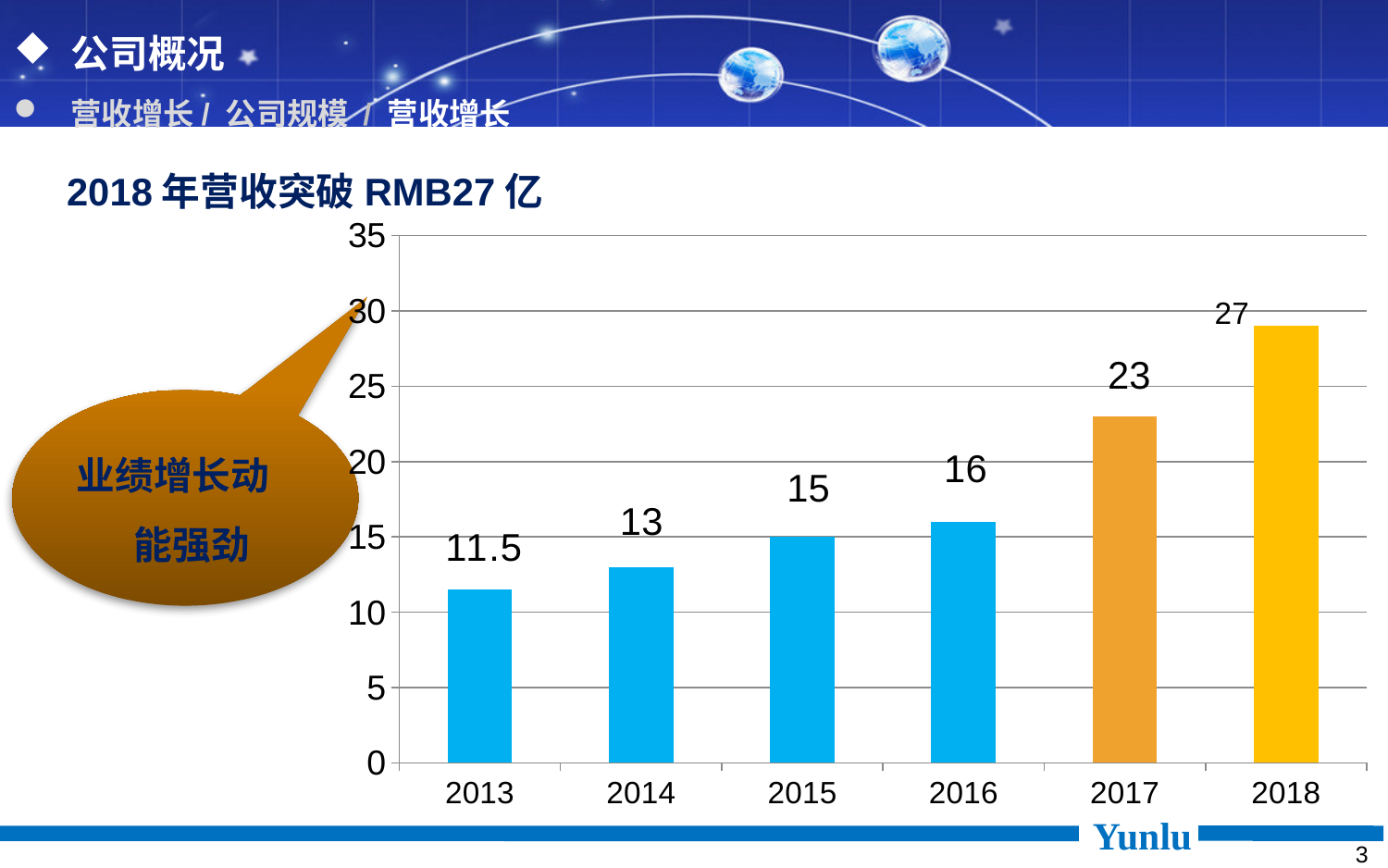
What is the difference between the values for 2014 and 2013? 1.5 Is the value for 2017 greater or less than 20? greater What is the value for 2016? 16 How many years are shown on the x axis? 6 Which year has the lowest value? 2013 Do the values rise or fall from 2013 to 2018? rise What is the value for 2013? 11.5 What is the difference between the values for 2018 and 2017? 4 Which is larger, the value for 2015 or the value for 2017? 2017 What kind of chart is shown on the slide? bar chart Which year has the highest value? 2018 What is the value for 2018? 27